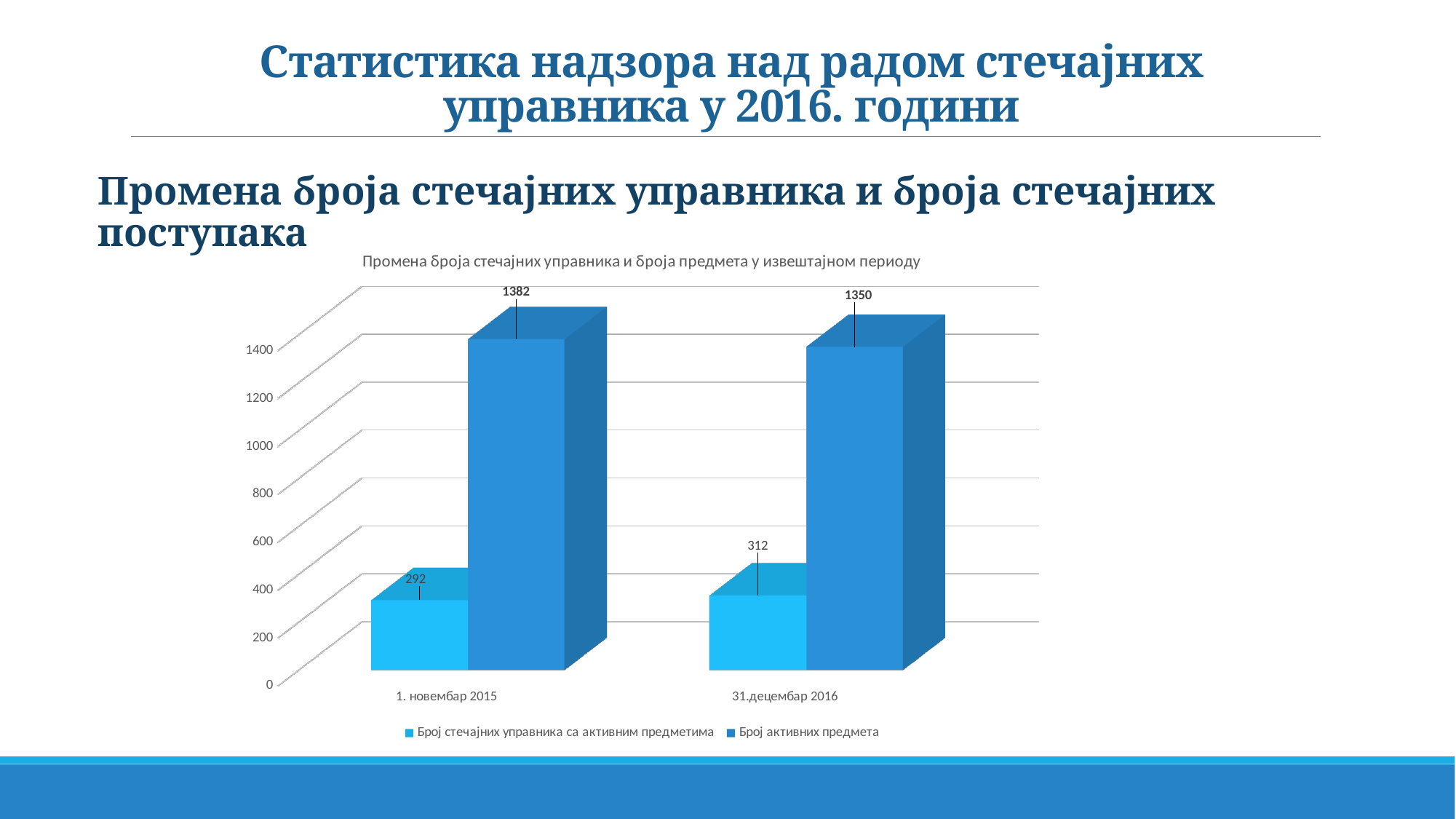
Which date has the lower value for 'Број стечајних управника са активним предметима'? 1. новембар 2015 What is the value of 'Број активних предмета' for '1. новембар 2015'? 1382 What kind of chart is shown on the slide? Bar chart What is the value of 'Број активних предмета' for '31.децембар 2016'? 1350 How many categories are shown on the x axis of the chart? 2 Which date has the higher value for 'Број активних предмета'? 1. новембар 2015 Is 'Број стечајних управника са активним предметима' larger on 1. новембар 2015 or on 31.децембар 2016? 31.децембар 2016 What is the difference between 'Број стечајних управника са активним предметима' on 31.децембар 2016 and on 1. новембар 2015? 20 How many series does the chart legend list? 2 What is the difference between 'Број активних предмета' on 1. новембар 2015 and on 31.децембар 2016? 32 What is the value of 'Број стечајних управника са активним предметима' for '1. новембар 2015'? 292 What is the value of 'Број стечајних управника са активним предметима' for '31.децембар 2016'? 312